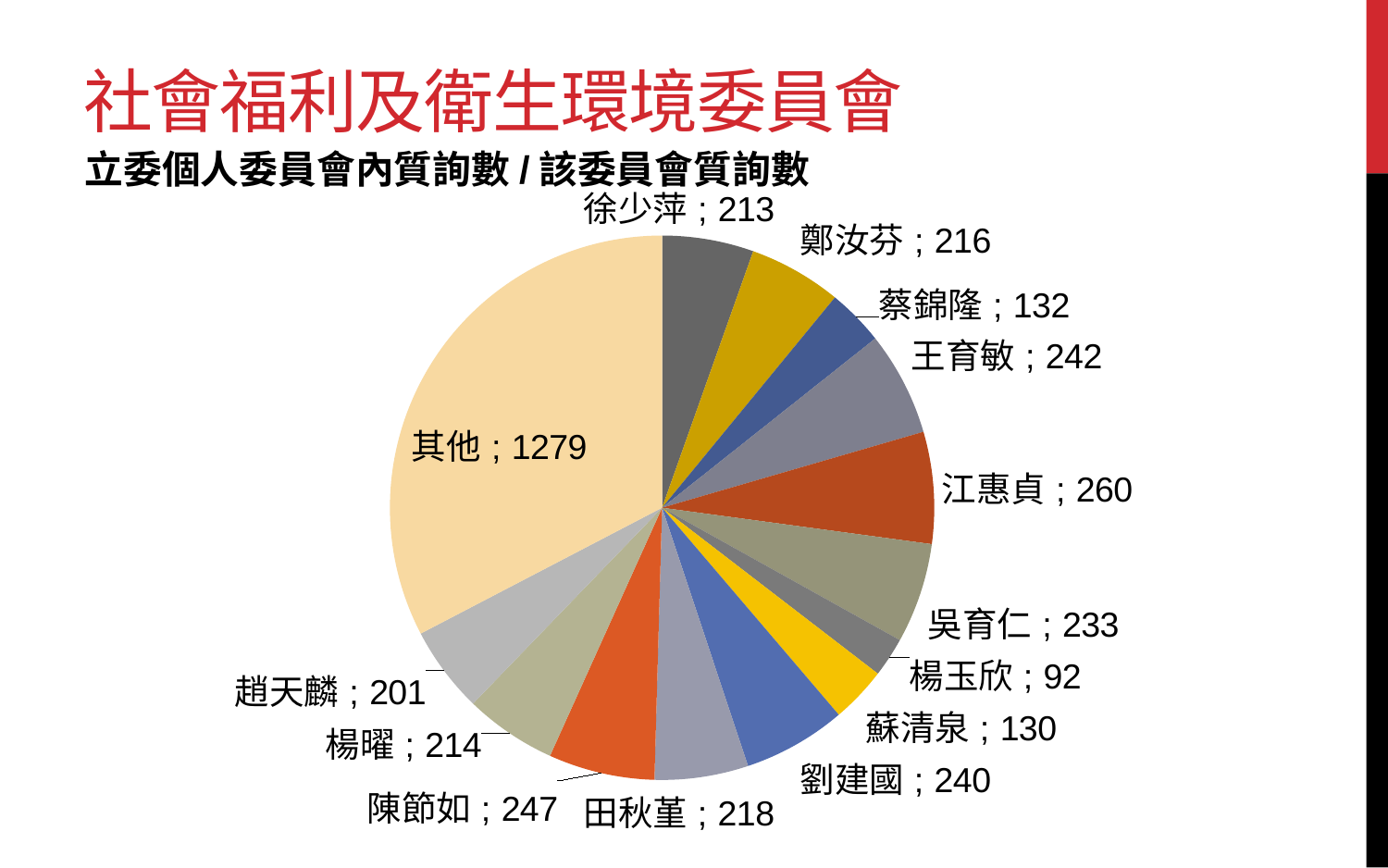
Excluding 其他, which legislator has the highest value? 江惠貞 What is the value for 其他? 1279 How many slices does the pie chart have? 14 What is the difference between the values for 王育敏 and 蔡錦隆? 110 Which is larger, the value for 劉建國 or the value for 蘇清泉? 劉建國 What type of chart is shown on the slide? pie chart Which slice has the largest value? 其他 What is the value for 陳節如? 247 Which slice has the smallest value? 楊玉欣 What is the value for 楊玉欣? 92 What is the subtitle printed above the pie chart? 立委個人委員會內質詢數 / 該委員會質詢數 What is the value for 江惠貞? 260